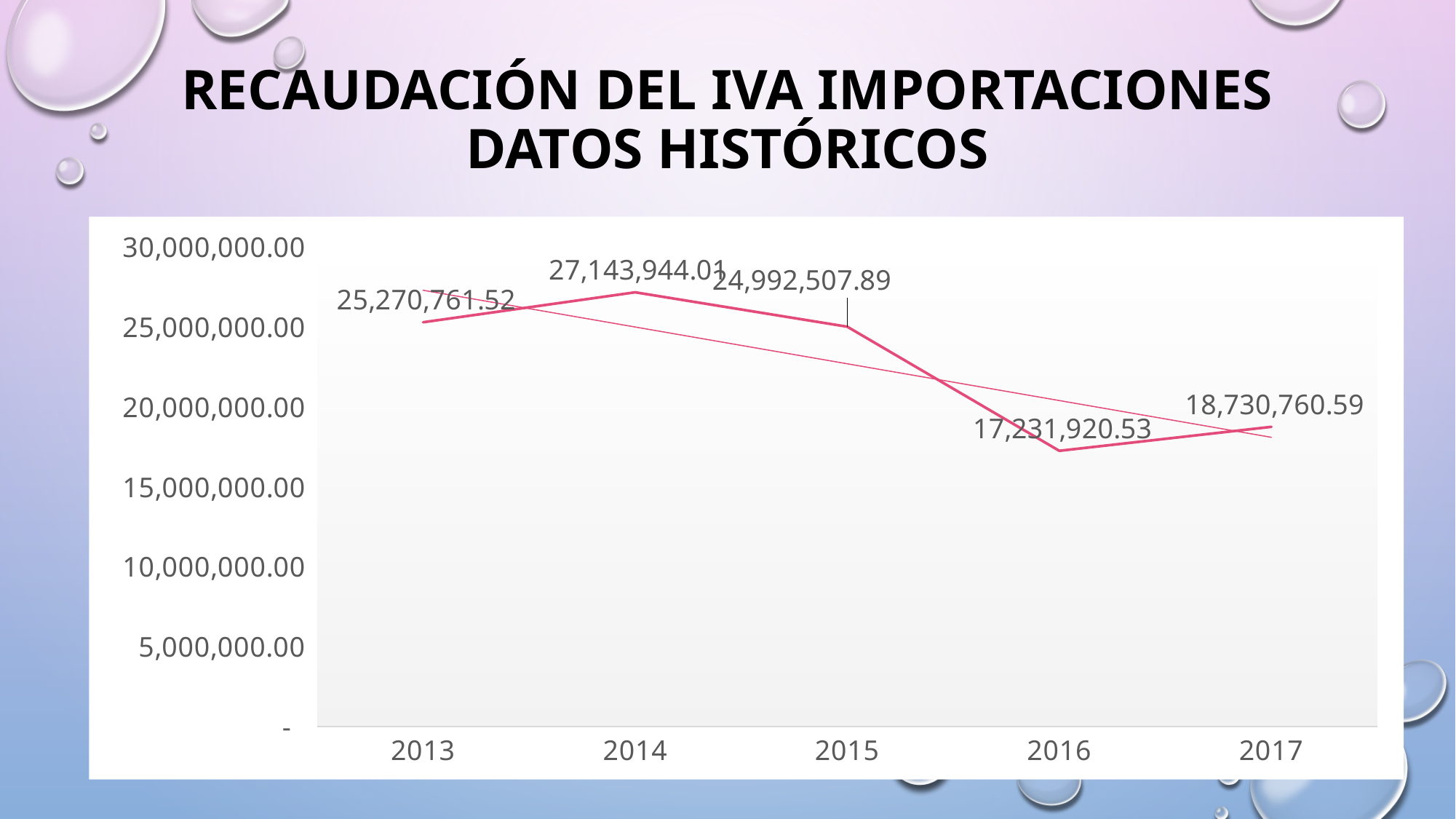
How many years are plotted on the chart? 5 Which year has the lowest value? 2016 Which year has the highest value? 2014 What is the difference between the values for 2014 and 2013? 1,873,182.49 What is the value for 2016? 17,231,920.53 What is the value for 2017? 18,730,760.59 What is the difference between the values for 2015 and 2016? 7,760,587.36 What kind of chart is shown on the slide? line chart Which is larger, the value for 2015 or the value for 2017? 2015 What is the value for 2013? 25,270,761.52 What is the value for 2014? 27,143,944.01 Is the value for 2016 greater or less than 20,000,000.00? less